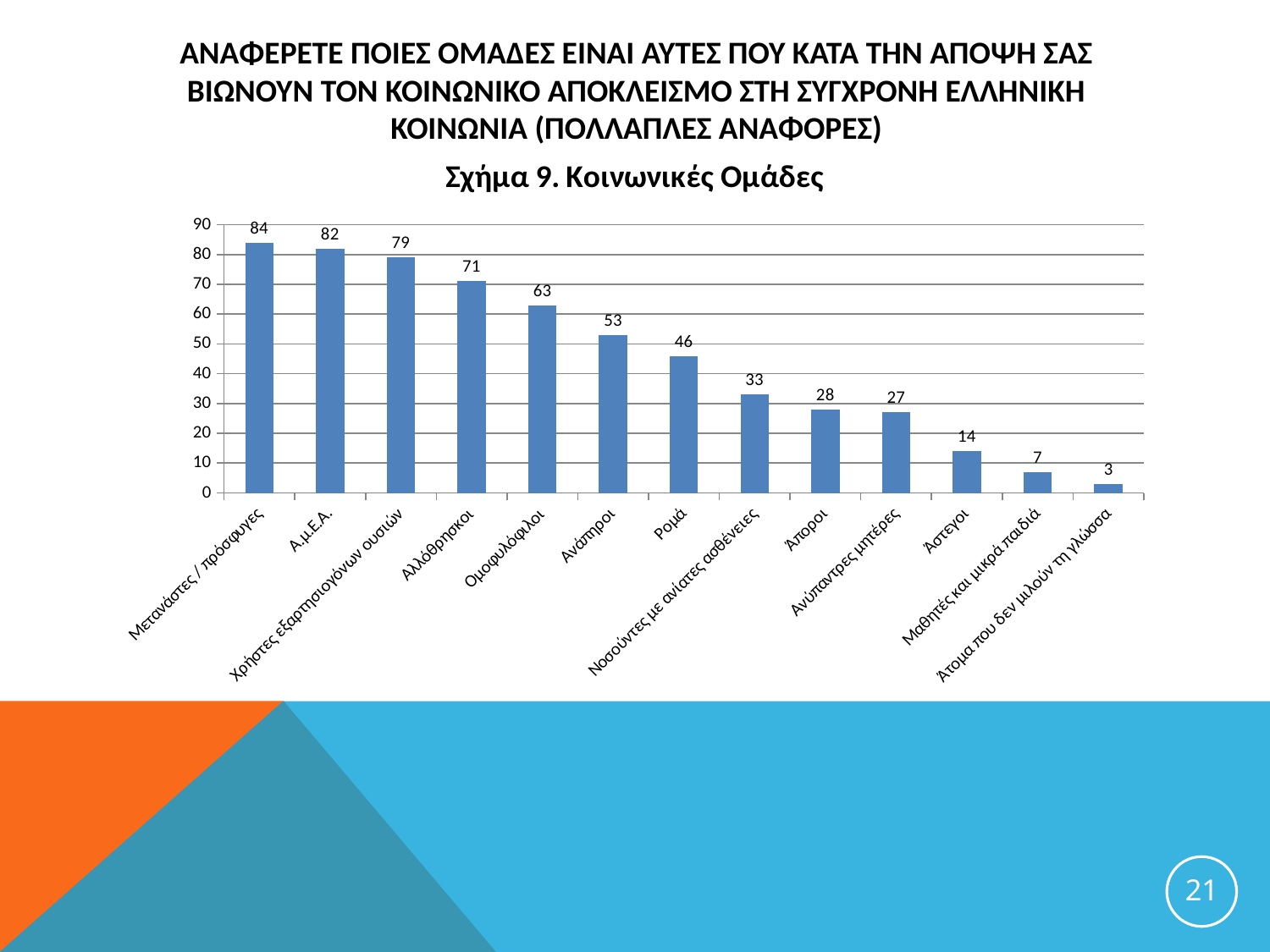
How many categories are shown on the x axis? 13 Is the value for Νοσούντες με ανίατες ασθένειες greater or less than 40? less What is the value for Μετανάστες / πρόσφυγες? 84 What kind of chart is shown on the slide? bar chart Which is larger, the value for Ομοφυλόφιλοι or the value for Ανάπηροι? Ομοφυλόφιλοι What is the title of the chart? Σχήμα 9. Κοινωνικές Ομάδες What is the difference between the values for Α.μ.Ε.Α. and Αλλόθρησκοι? 11 Which category has the highest value? Μετανάστες / πρόσφυγες Do the values rise or fall from left to right along the x axis? fall What is the value for Ρομά? 46 Which category has the lowest value? Άτομα που δεν μιλούν τη γλώσσα What is the value for Άστεγοι? 14